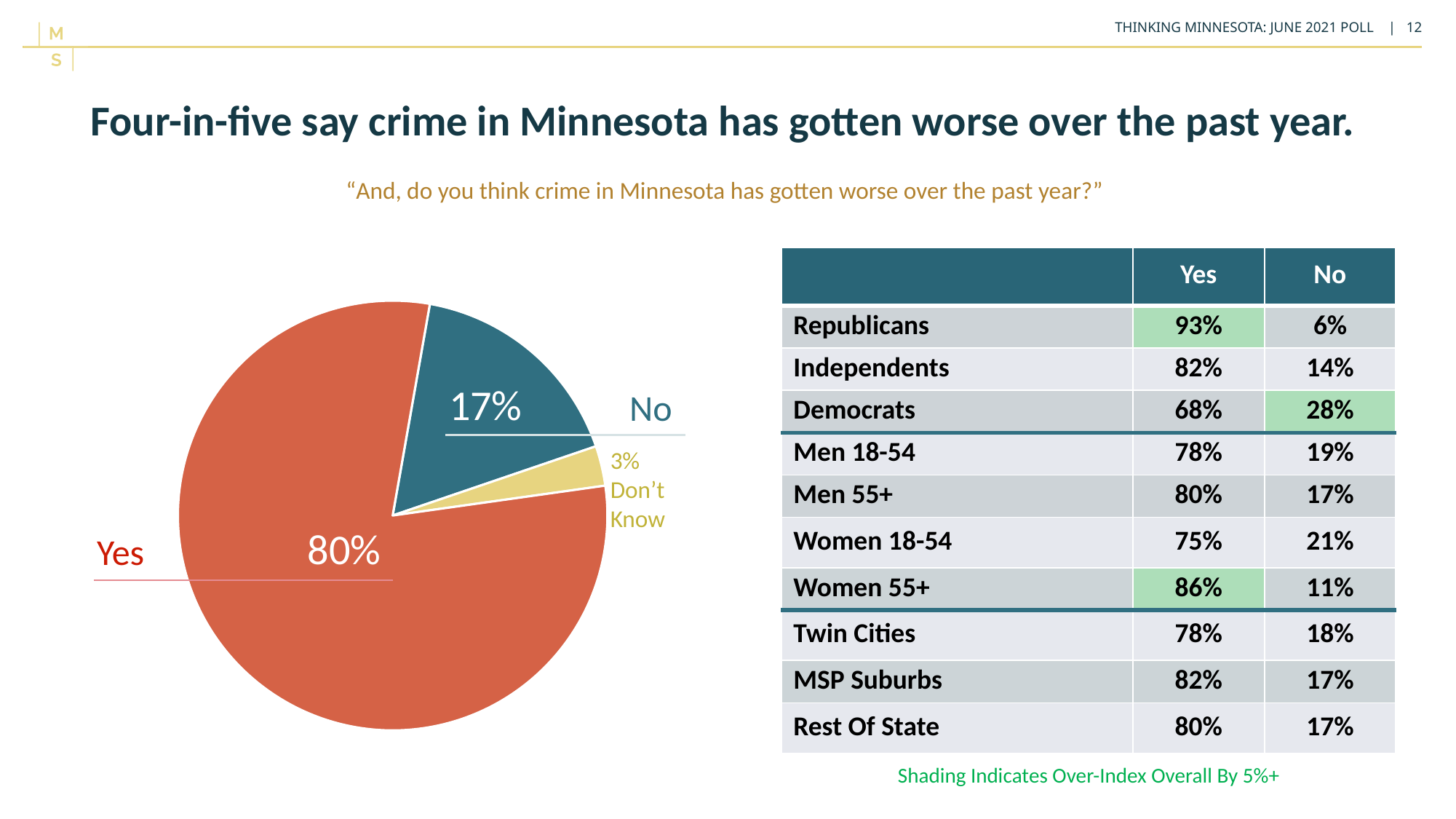
Which is larger in the pie chart, the No slice or the Don't Know slice? No How many slices does the pie chart have? 3 In the pie chart, what share of respondents answered Don't Know? 3% What colour is the Yes slice in the pie chart? red/orange What survey question is the pie chart based on, as quoted on the slide? "And, do you think crime in Minnesota has gotten worse over the past year?" In the pie chart, what share of respondents answered Yes? 80% Which slice of the pie chart is the largest? Yes What is the combined share of the No and Don't Know slices in the pie chart? 20% What is the difference in percentage points between the Yes slice and the No slice in the pie chart? 63 Which slice of the pie chart is the smallest? Don't Know What kind of chart is shown on the slide? pie chart In the pie chart, what share of respondents answered No? 17%